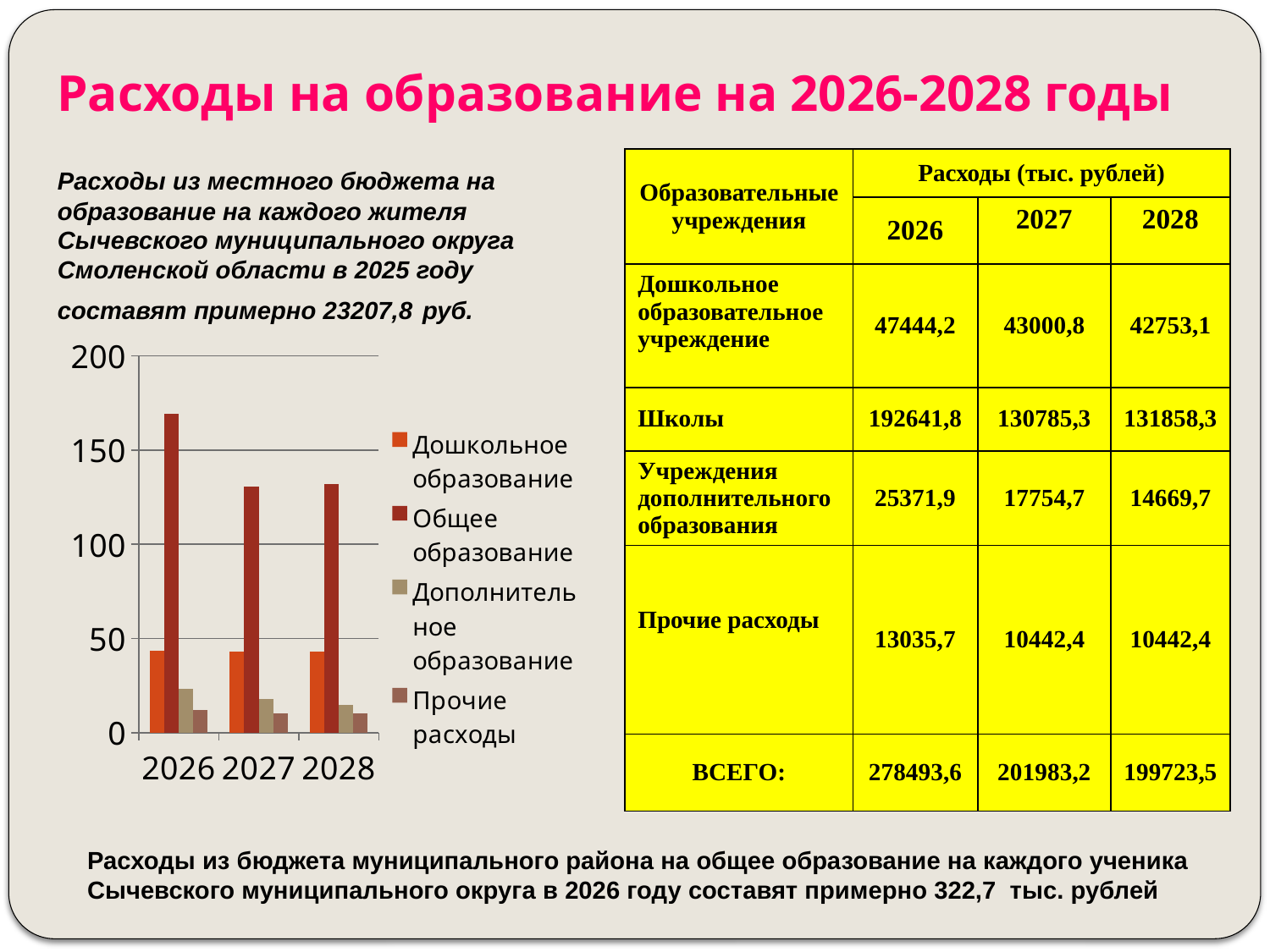
How many series does the chart legend list? 4 What kind of chart is shown on the slide? bar chart Is the value for Дошкольное образование in 2026 greater or less than 50? less Is the value for Общее образование in 2027 greater or less than 100? greater Which series has the tallest bar in the chart? Общее образование Which series has the lowest bars in every year? Прочие расходы In which year is the bar for Общее образование the highest? 2026 Is the value for Общее образование in 2026 greater or less than 150? greater Does the value for Дополнительное образование rise or fall from 2026 to 2028? fall Which is larger: Общее образование in 2026 or Общее образование in 2027? 2026 What is the highest value shown on the chart's vertical axis? 200 How many years are shown on the x axis of the chart? 3